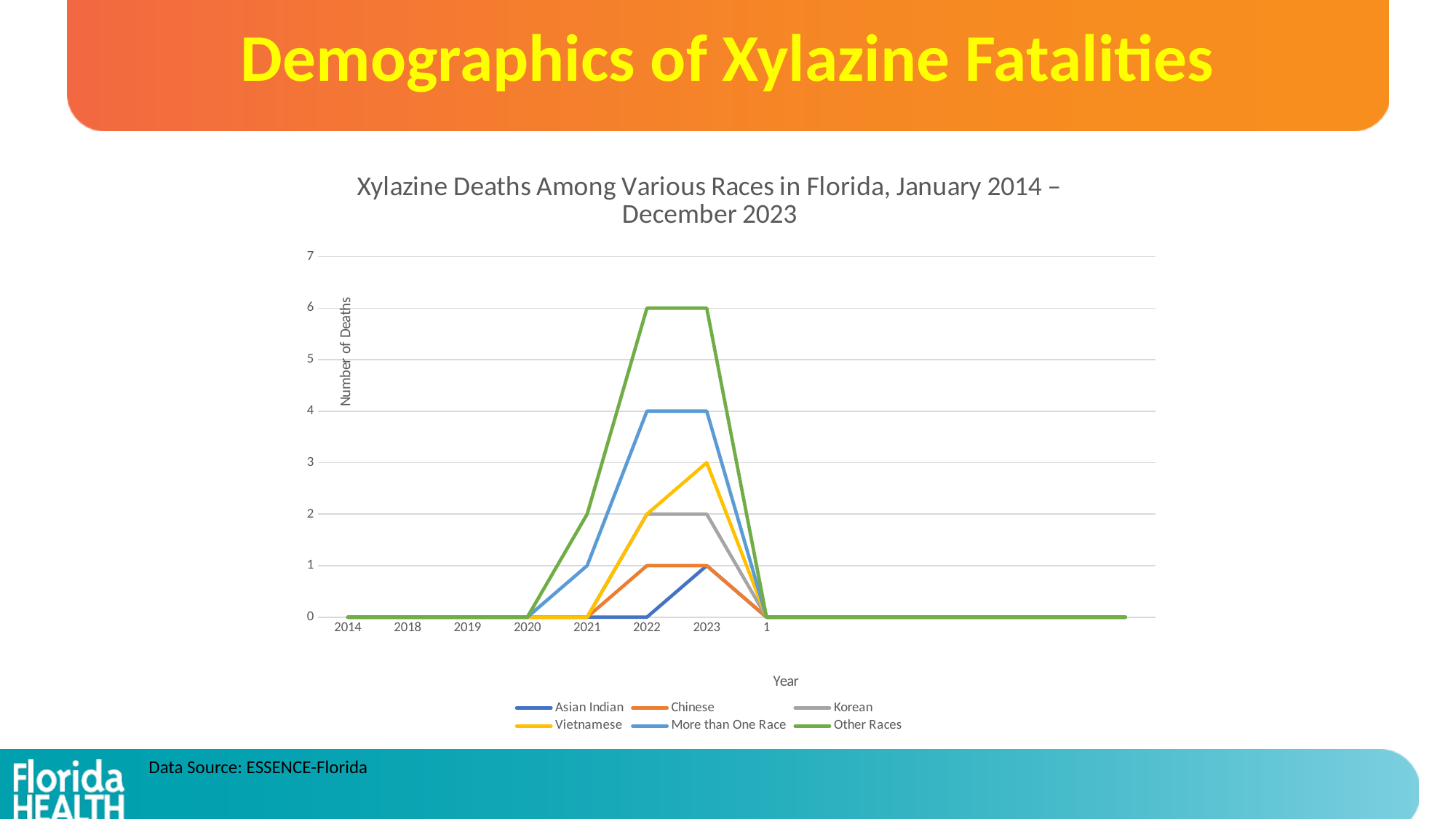
What kind of chart is shown on the slide? line chart What is the label on the vertical axis of the chart? Number of Deaths How many series does the legend list? 6 Does the Other Races line rise or fall from 2021 to 2022? rise